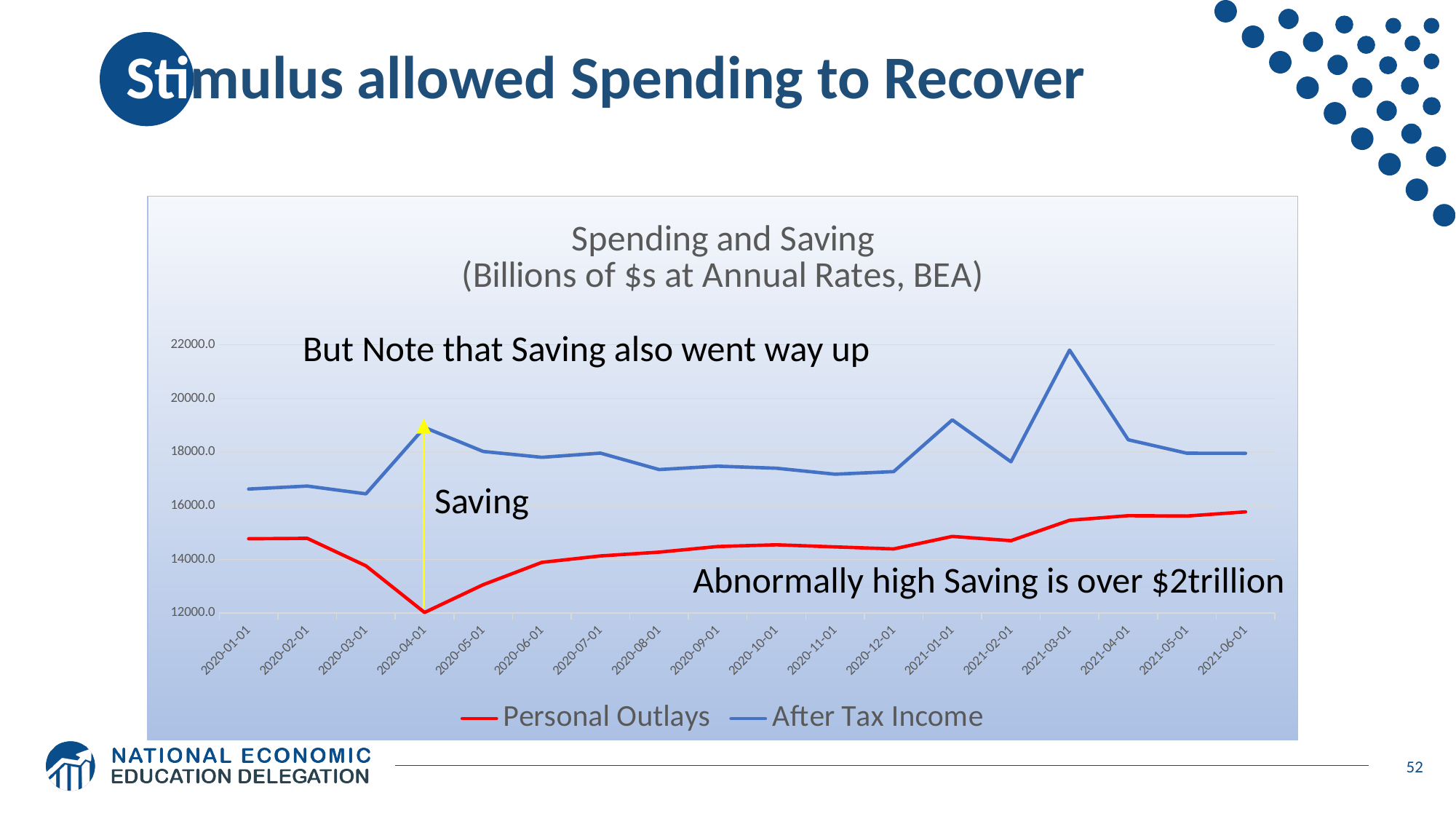
Is the value of Personal Outlays on 2020-04-01 greater or less than 14000.0? less Which colour is used for the Personal Outlays line? red Is the value of After Tax Income on 2021-03-01 greater or less than 20000.0? greater Do Personal Outlays generally rise or fall from 2020-04-01 to 2021-06-01? rise How many series does the chart legend list? 2 How many dates are plotted along the x axis of the chart? 18 On which date does After Tax Income reach its highest value? 2021-03-01 On which date do Personal Outlays reach their lowest value? 2020-04-01 On 2020-04-01, which is larger: Personal Outlays or After Tax Income? After Tax Income Is the value of After Tax Income on 2020-01-01 greater or less than 16000.0? greater What kind of chart is shown on the slide? line chart What is the title of the chart? Spending and Saving (Billions of $s at Annual Rates, BEA)